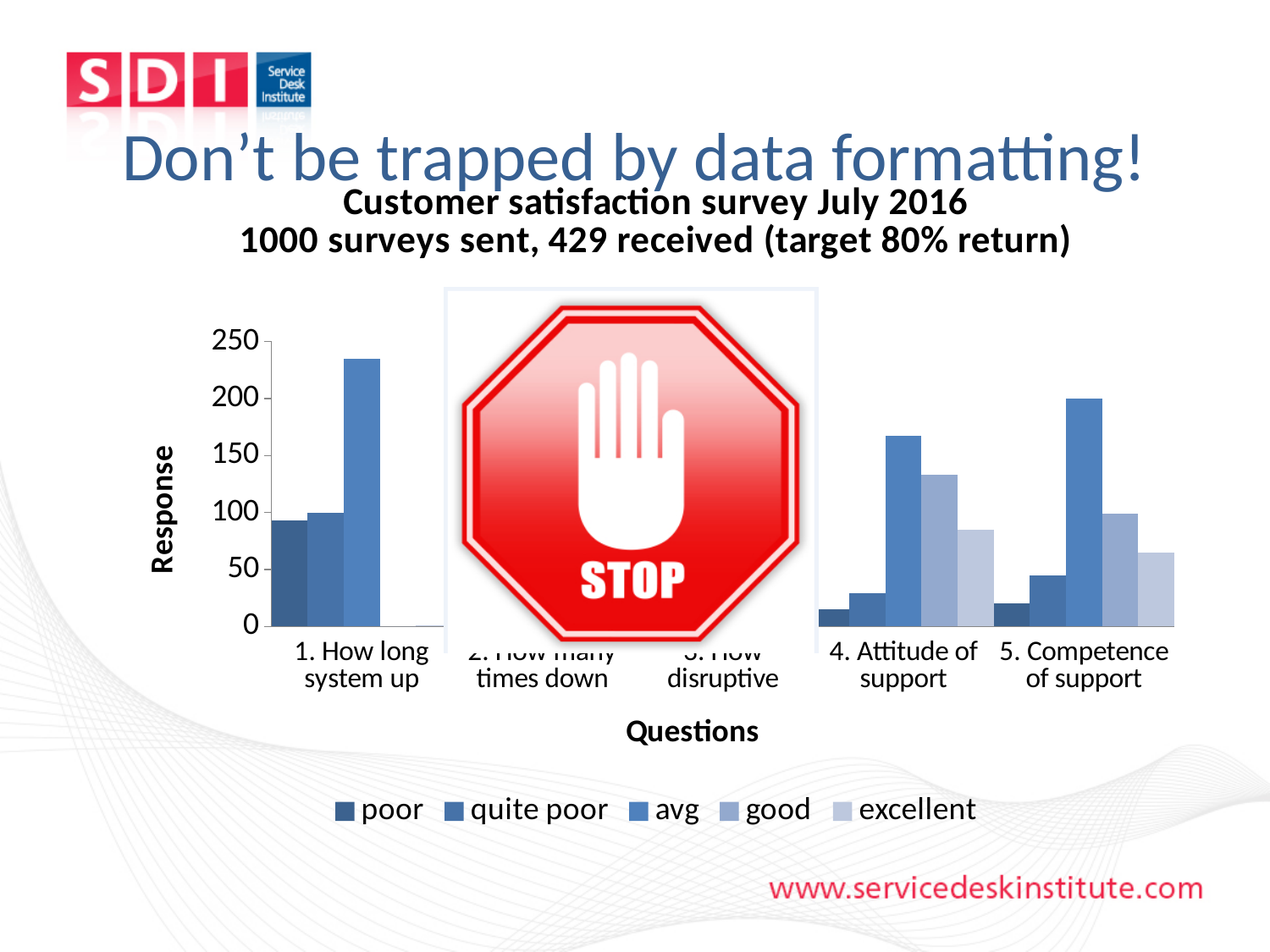
Is the 'good' value for '4. Attitude of support' greater or less than 100? greater Which series has the lowest value for '4. Attitude of support'? poor Which series has the highest value for '5. Competence of support'? avg Is the 'avg' value for '4. Attitude of support' greater or less than 150? greater How many series does the legend list? 5 Is the 'excellent' value for '4. Attitude of support' greater or less than 100? less How many question categories are shown along the x axis? 5 What kind of chart is shown on the slide? bar chart What are the legend entries of the chart? poor, quite poor, avg, good, excellent Which is larger, the 'avg' value for '5. Competence of support' or the 'avg' value for '4. Attitude of support'? 5. Competence of support What is the title of the vertical axis? Response